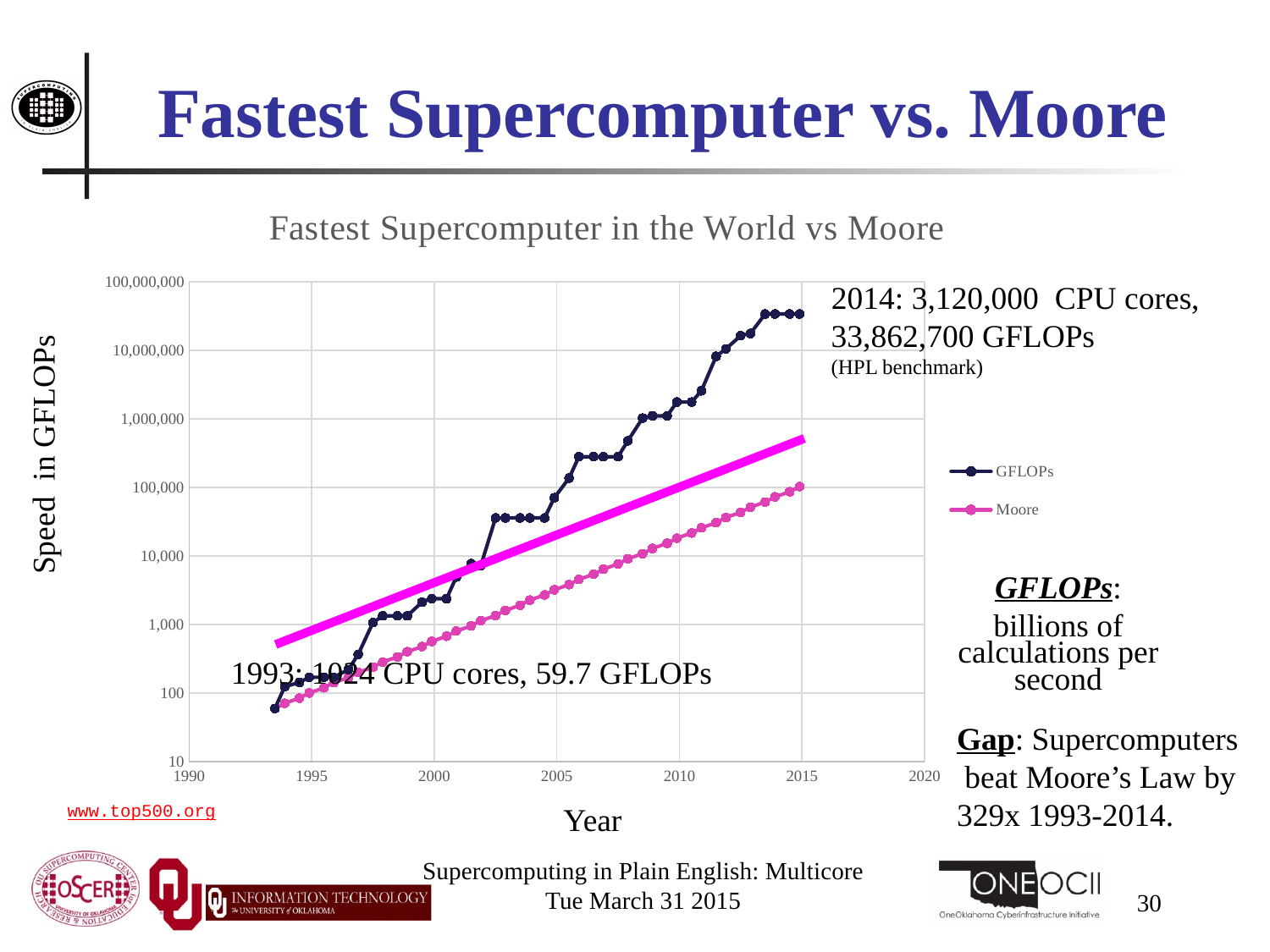
Does the GFLOPs series rise or fall as the year increases? rise Is the Moore value for 2015 greater or less than 1,000,000? less Is the GFLOPs value for 2010 greater or less than 1,000,000? greater What are the two series named in the chart's legend? GFLOPs and Moore What kind of chart is shown on the slide? line chart In 2014, which series has the larger value, GFLOPs or Moore? GFLOPs Is the Moore value for 2010 greater or less than 10,000? greater How many series does the chart's legend list? 2 What is the title of the chart? Fastest Supercomputer in the World vs Moore According to the annotation on the chart, how many GFLOPs did the fastest supercomputer reach in 2014? 33,862,700 GFLOPs According to the annotation on the chart, how many GFLOPs did the fastest supercomputer reach in 1993? 59.7 GFLOPs